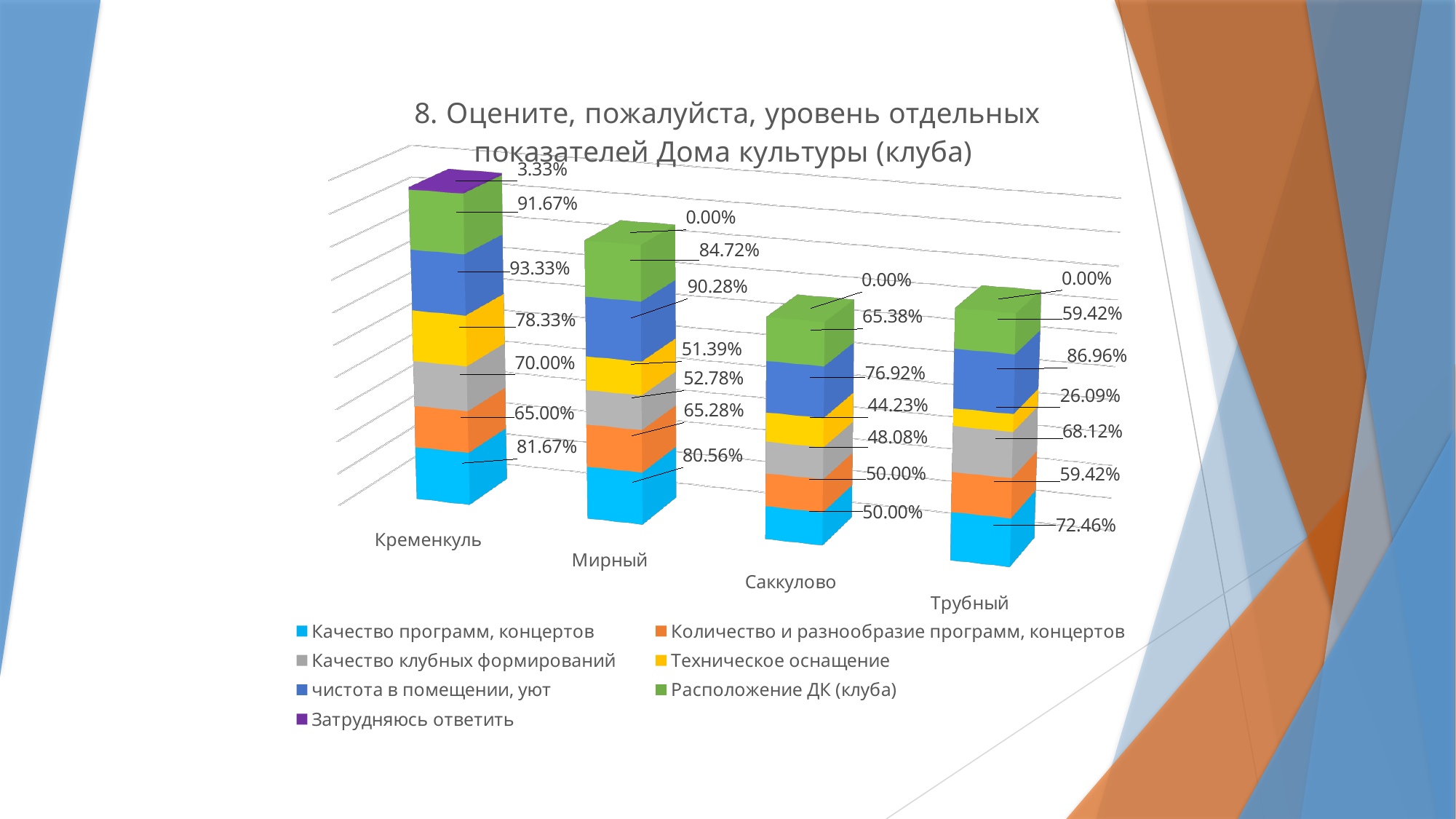
What is the difference between the "Качество программ, концертов" values for Кременкуль and Саккулово? 31.67% How many categories (settlements) are shown on the x axis? 4 What is the value of "чистота в помещении, уют" for Мирный? 90.28% What is the value of "Расположение ДК (клуба)" for Саккулово? 65.38% Which settlement has the lowest value for "Техническое оснащение"? Трубный Which is larger: "Качество клубных формирований" for Мирный or for Трубный? Трубный Which settlement has the highest value for "чистота в помещении, уют"? Кременкуль What is the value of "Качество программ, концертов" for Кременкуль? 81.67% What kind of chart is shown on the slide? stacked bar chart Which settlement is the only one with a non-zero value for "Затрудняюсь ответить"? Кременкуль How many series does the legend list? 7 What is the value of "Техническое оснащение" for Трубный? 26.09%